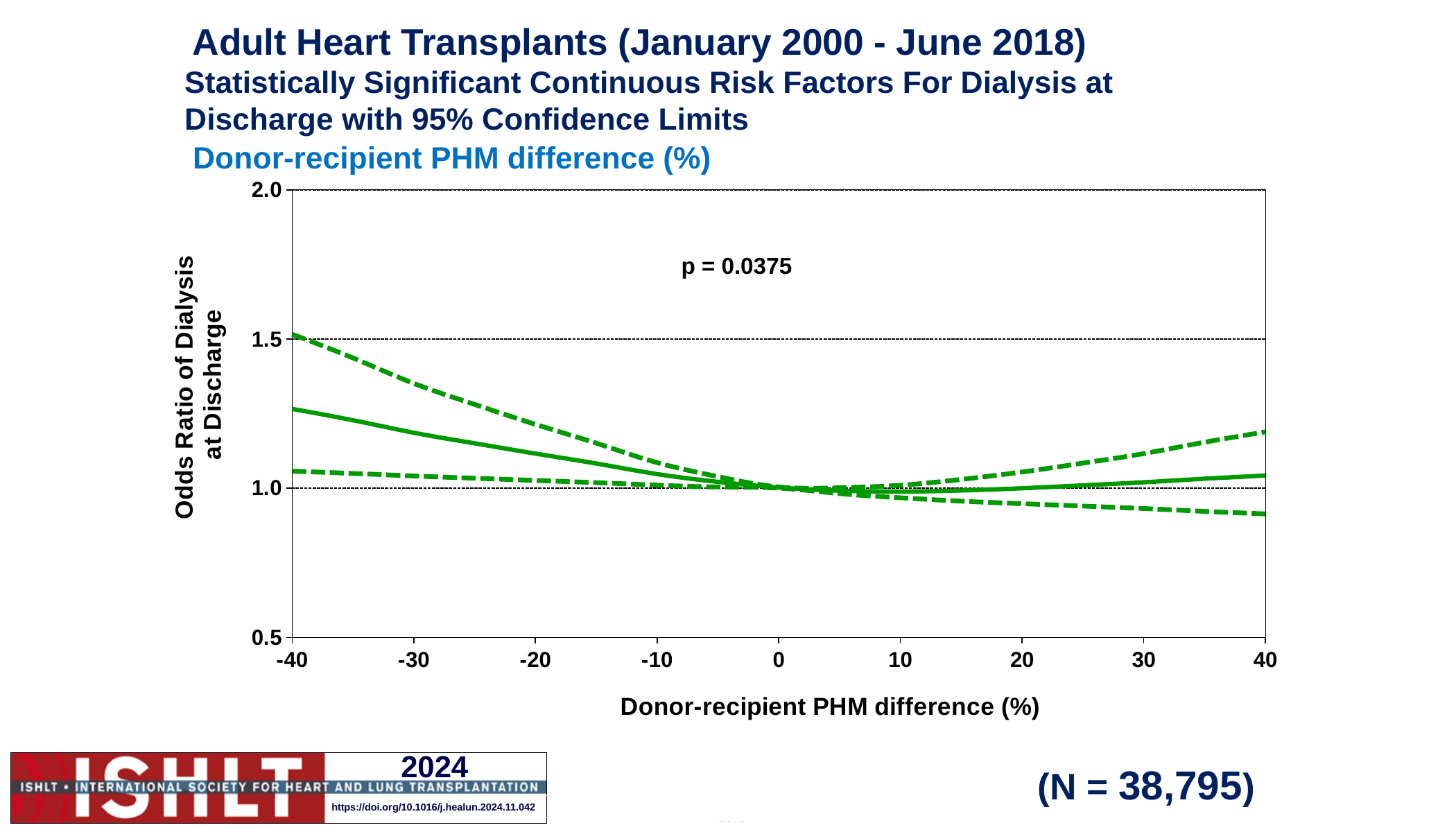
What kind of chart is shown on the slide? line chart Is the solid line's odds ratio at a donor-recipient PHM difference of -40% greater or less than 1.0? greater What is the highest value shown on the y axis? 2.0 Is the upper dashed confidence limit at a donor-recipient PHM difference of 40% greater or less than 1.0? greater Is the upper dashed confidence limit at a donor-recipient PHM difference of -40% greater or less than 1.0? greater Does the solid odds ratio line rise or fall as the donor-recipient PHM difference goes from -40% to 0%? fall What p-value is printed on the chart? p = 0.0375 Is the solid line's odds ratio higher at a donor-recipient PHM difference of -40% or at 40%? -40% How many lines are plotted on the chart? 3 What is the label of the x axis? Donor-recipient PHM difference (%)